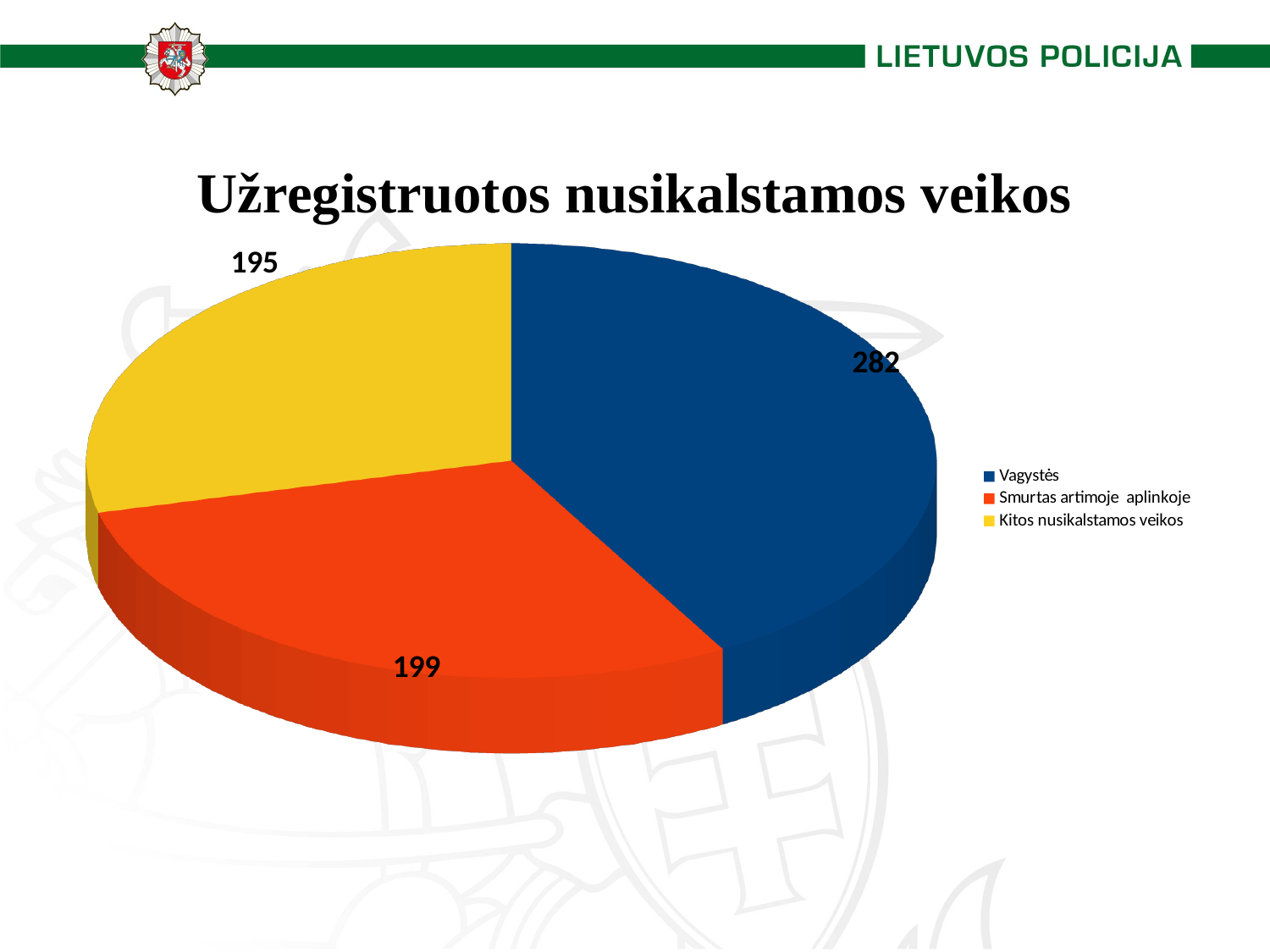
Which category has the lowest value? Kitos nusikalstamos veikos Which is larger, the value for Vagystės or the value for Kitos nusikalstamos veikos? Vagystės What is the value for Kitos nusikalstamos veikos? 195 What is the difference between the values for Smurtas artimoje aplinkoje and Kitos nusikalstamos veikos? 4 What colour is the slice for Smurtas artimoje aplinkoje? red What is the value for Vagystės? 282 What is the value for Smurtas artimoje aplinkoje? 199 What is the title of the chart? Užregistruotos nusikalstamos veikos Which category has the highest value? Vagystės What type of chart is shown on the slide? pie chart What is the difference between the values for Vagystės and Smurtas artimoje aplinkoje? 83 How many slices does the pie chart have? 3